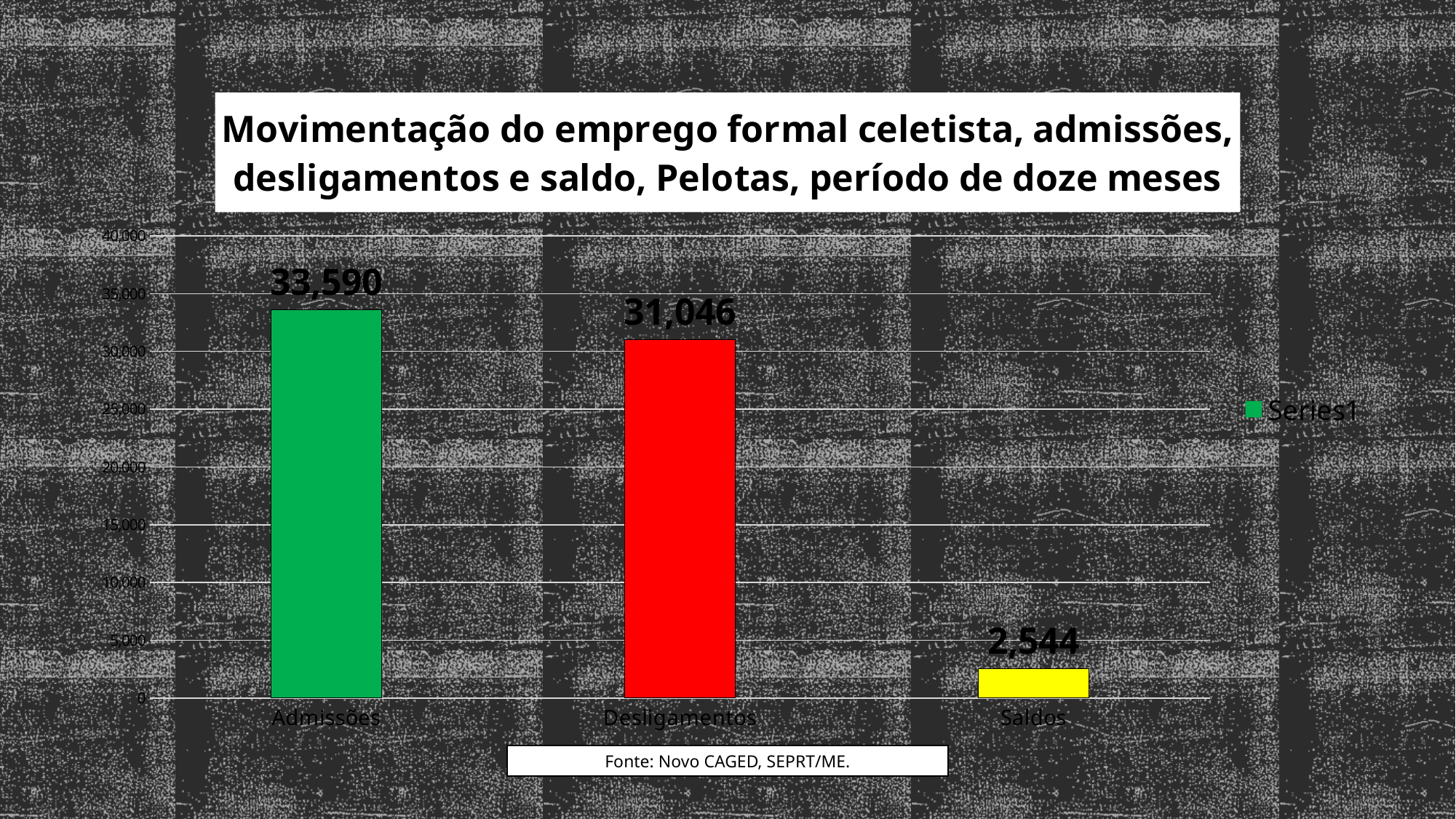
What is the value for Admissões? 33,590 What is the difference between Admissões and Desligamentos? 2,544 Which is larger, Desligamentos or Saldos? Desligamentos How many series does the legend list? 1 Which category has the highest value? Admissões How many categories are shown on the x axis? 3 What is the value for Desligamentos? 31,046 What is the value for Saldos? 2,544 Which category has the lowest value? Saldos What colour is the bar for Saldos? yellow What kind of chart is shown? bar chart Is the value for Desligamentos greater or less than 30,000? greater